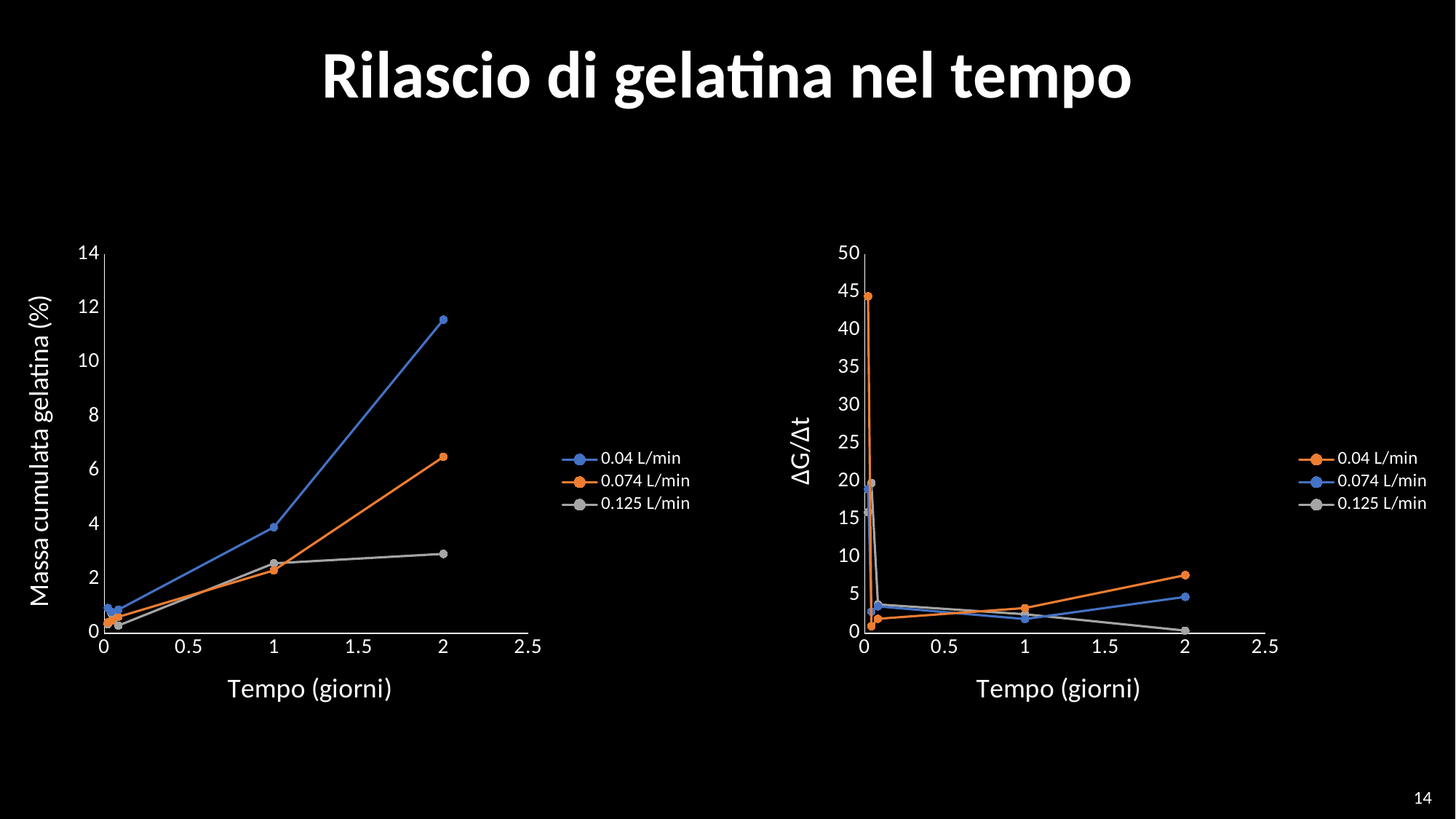
What kind of chart is the left chart (Massa cumulata gelatina)? line chart In the right chart (ΔG/Δt), is the first value for 0.04 L/min greater or less than 40? greater In the left chart, does the 0.04 L/min series rise or fall from 0 to 2 days? rise In the left chart, is the value for 0.125 L/min at 2 days greater or less than 4? less What is the y-axis title of the left chart? Massa cumulata gelatina (%) In the right chart (ΔG/Δt), which series has the highest value at 2 days? 0.04 L/min How many series does the legend of the left chart list? 3 In the left chart, is the value for 0.04 L/min at 2 days greater or less than 10? greater In the left chart, which is larger at 2 days: 0.074 L/min or 0.125 L/min? 0.074 L/min How many series does the legend of the right chart (ΔG/Δt) list? 3 In the right chart (ΔG/Δt), does the 0.125 L/min series rise or fall from 1 to 2 days? fall In the left chart, which series has the highest value at 2 days? 0.04 L/min